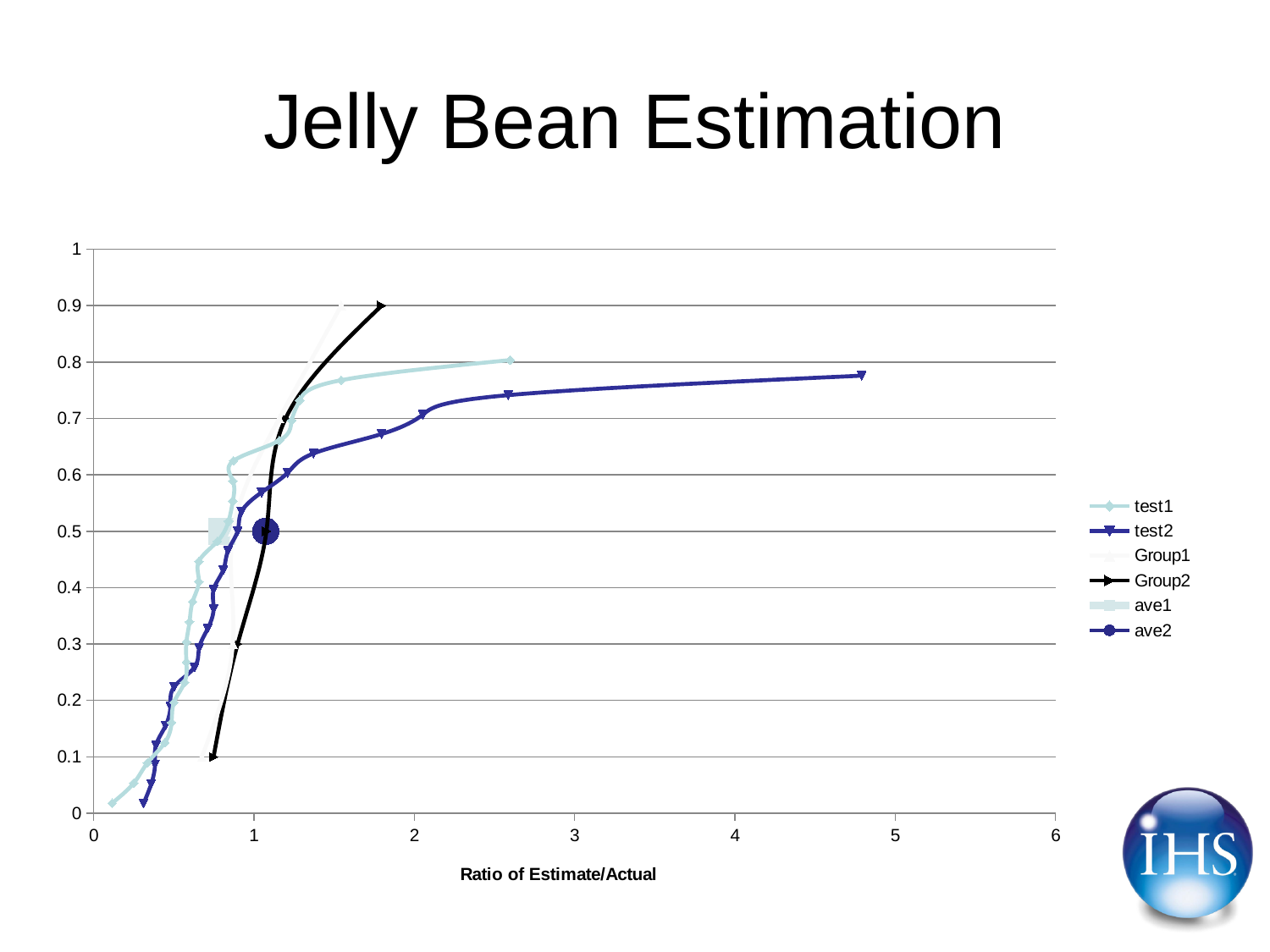
Is the x value of the ave2 marker greater or less than 1? greater What kind of chart is shown on the slide? line chart How many series does the legend list? 6 Which series reaches the highest y value on the chart? Group1 and Group2 (both reach 0.9) What is the label of the x axis? Ratio of Estimate/Actual Along the x axis, do the y values of the test2 series rise or fall? rise Is the largest x value reached by the test2 series greater or less than 4? greater What is the title of the chart? Jelly Bean Estimation Is the x value of the topmost point of the Group2 series greater or less than 2? less Which series extends to a larger x value, test1 or test2? test2